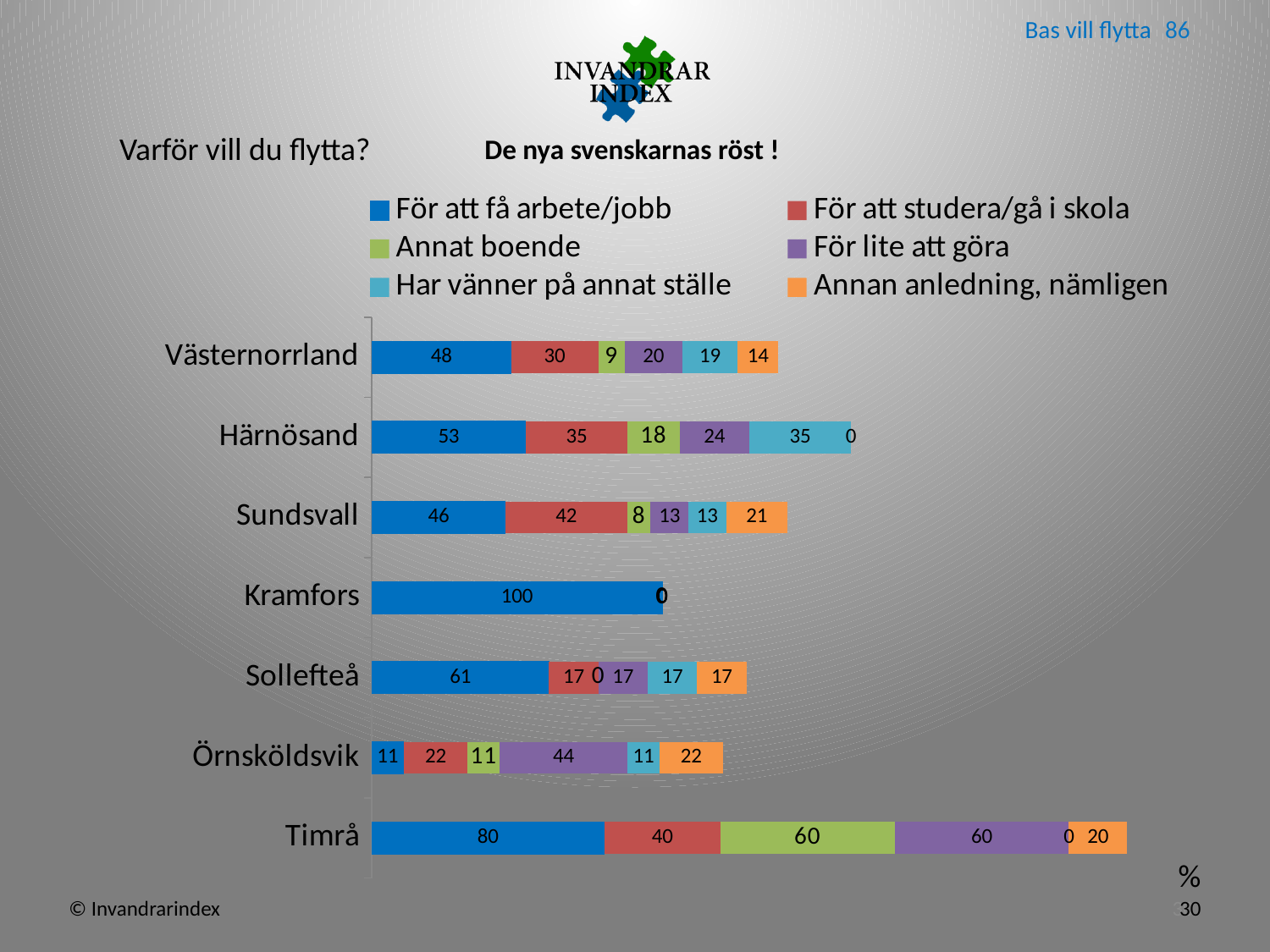
What is the value for 'För att få arbete/jobb' for Härnösand? 53 What is the title of the chart? Varför vill du flytta? How many series does the legend list? 6 What is the total of the stacked bar for Västernorrland? 140 What is the value for 'För lite att göra' for Örnsköldsvik? 44 What is the difference between the 'För att studera/gå i skola' values for Sundsvall and Västernorrland? 12 What kind of chart is shown on the slide? Stacked bar chart What is the value for 'Annat boende' for Timrå? 60 Which category has the highest value for 'För att få arbete/jobb'? Kramfors How many categories (regions/municipalities) are shown on the chart? 7 Which is larger: the 'Har vänner på annat ställe' value for Härnösand or for Sundsvall? Härnösand Which category has the lowest value for 'För att få arbete/jobb'? Örnsköldsvik